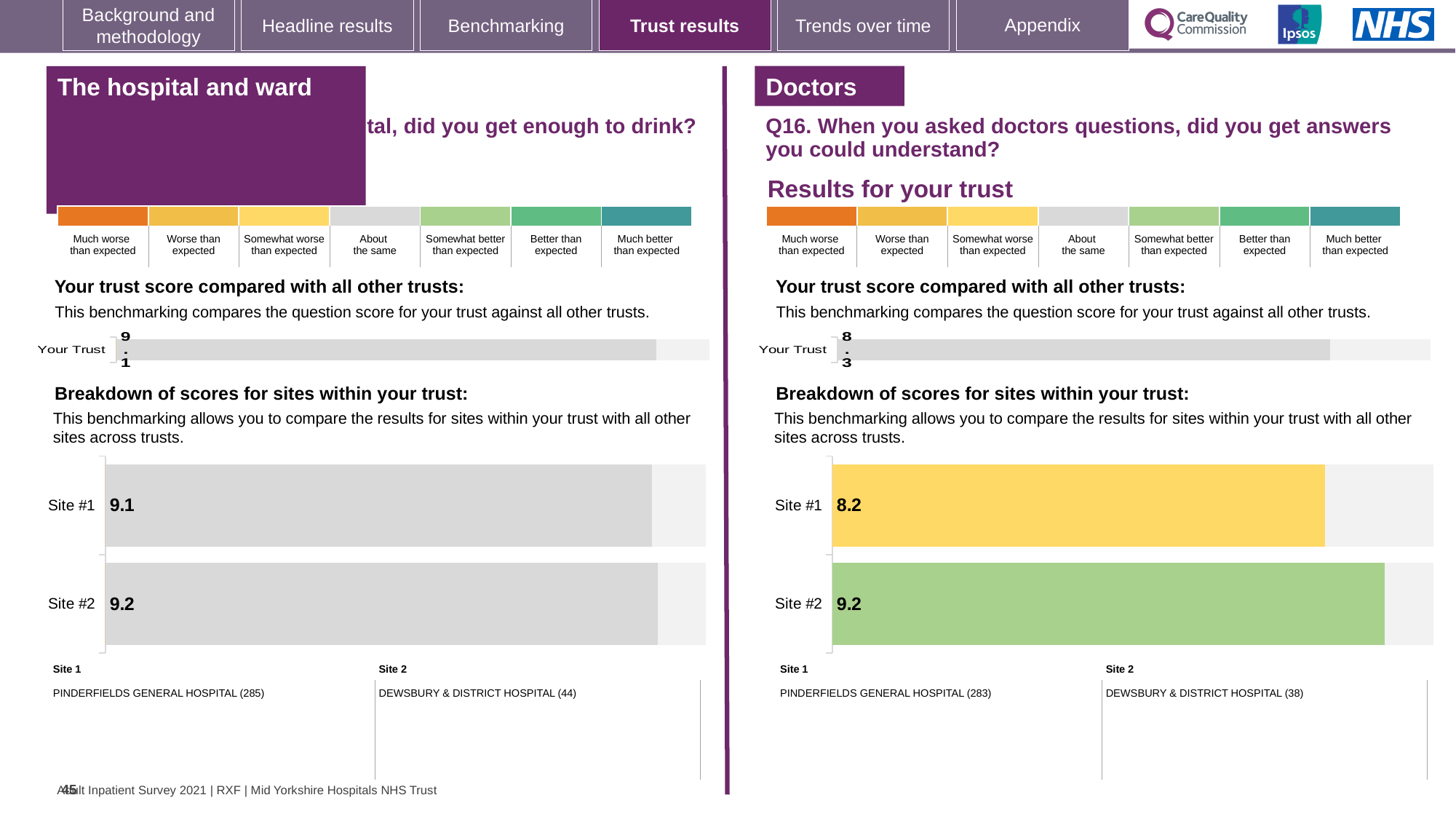
In the 'Doctors' (Q16) section on the right, what is the score shown for Site #1 in the breakdown of scores for sites chart? 8.2 How many sites are shown in the 'Doctors' (Q16) breakdown of scores for sites chart? 2 In the 'The hospital and ward' breakdown of scores for sites chart, what is the difference between the Site #2 and Site #1 scores? 0.1 In the 'The hospital and ward' section on the left, what is the score shown for Site #2 in the breakdown of scores for sites chart? 9.2 In the 'Doctors' (Q16) breakdown of scores for sites chart, what colour is the bar for Site #2? Light green In the 'Doctors' (Q16) breakdown of scores for sites chart, what is the difference between the Site #2 and Site #1 scores? 1.0 What kind of chart is used for the breakdown of scores for sites in the 'Doctors' (Q16) section? Bar chart In the 'The hospital and ward' section on the left, what is the score shown for Site #1 in the breakdown of scores for sites chart? 9.1 In the 'Doctors' (Q16) breakdown of scores for sites chart, which site has the higher score? Site #2 In the 'The hospital and ward' section on the left, what is the 'Your Trust' score in the trust score chart? 9.1 In the 'Doctors' (Q16) section on the right, what is the 'Your Trust' score in the trust score chart? 8.3 In the 'Doctors' (Q16) section on the right, what is the score shown for Site #2 in the breakdown of scores for sites chart? 9.2